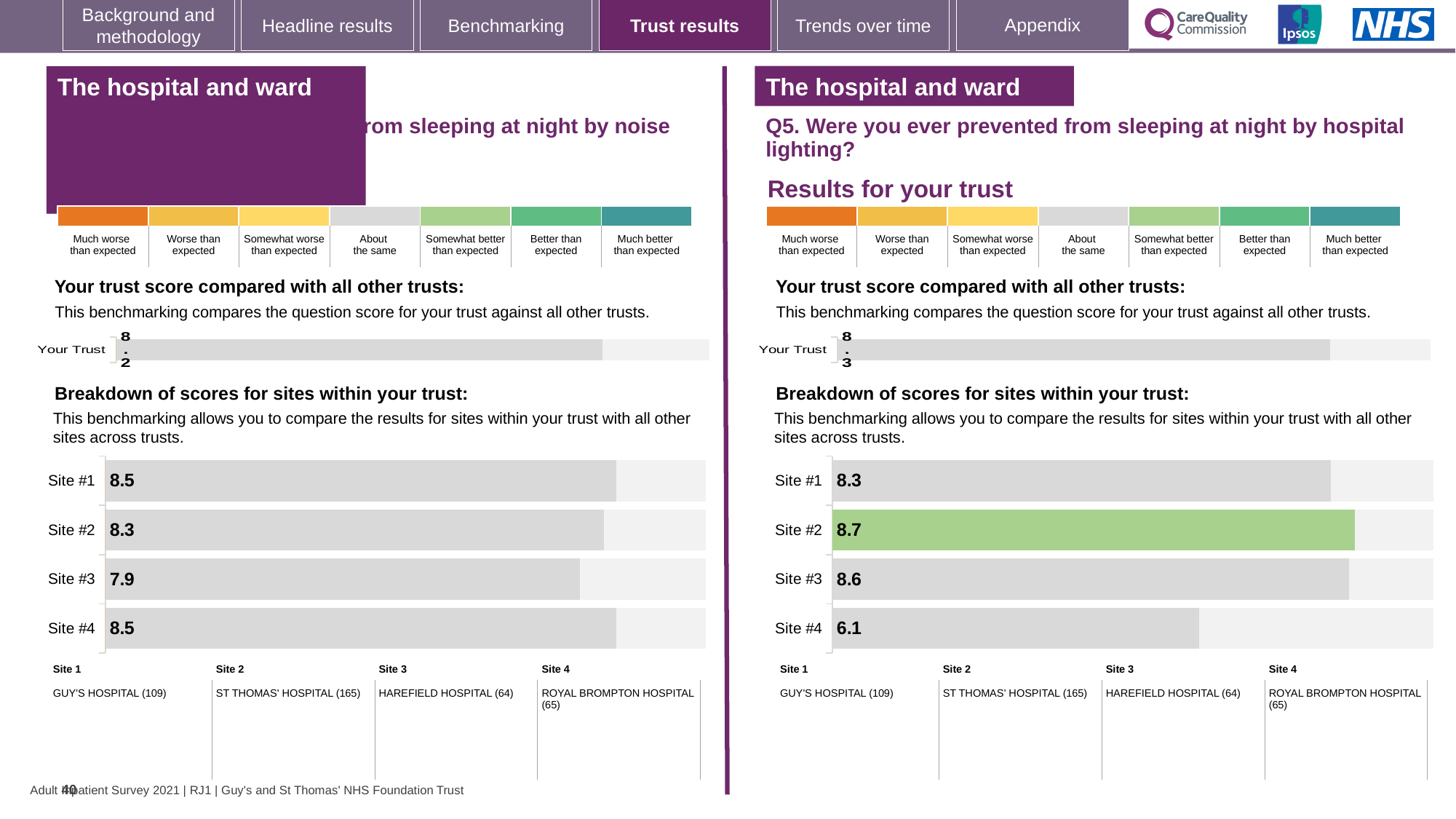
In the left-hand site breakdown chart, what is the score for Site #3? 7.9 What type of chart is used for the site breakdown on the right-hand side? Bar chart In the right-hand chart (Q5, hospital lighting), what is the score for Site #4? 6.1 In the left-hand site breakdown chart, which site has the lowest score? Site #3 In the left-hand site breakdown chart, which is larger: the score for Site #2 or Site #3? Site #2 In the right-hand chart (Q5, hospital lighting), which site has the highest score? Site #2 How many sites are shown in the right-hand site breakdown chart? 4 In the right-hand chart (Q5, hospital lighting), what is the difference between the scores for Site #2 and Site #4? 2.6 In the left-hand site breakdown chart, what is the difference between the scores for Site #1 and Site #3? 0.6 In the right-hand chart (Q5, hospital lighting), what is the score for Site #2? 8.7 In the left-hand site breakdown chart, what is the score for Site #2? 8.3 In the right-hand chart (Q5, hospital lighting), which site has the lowest score? Site #4